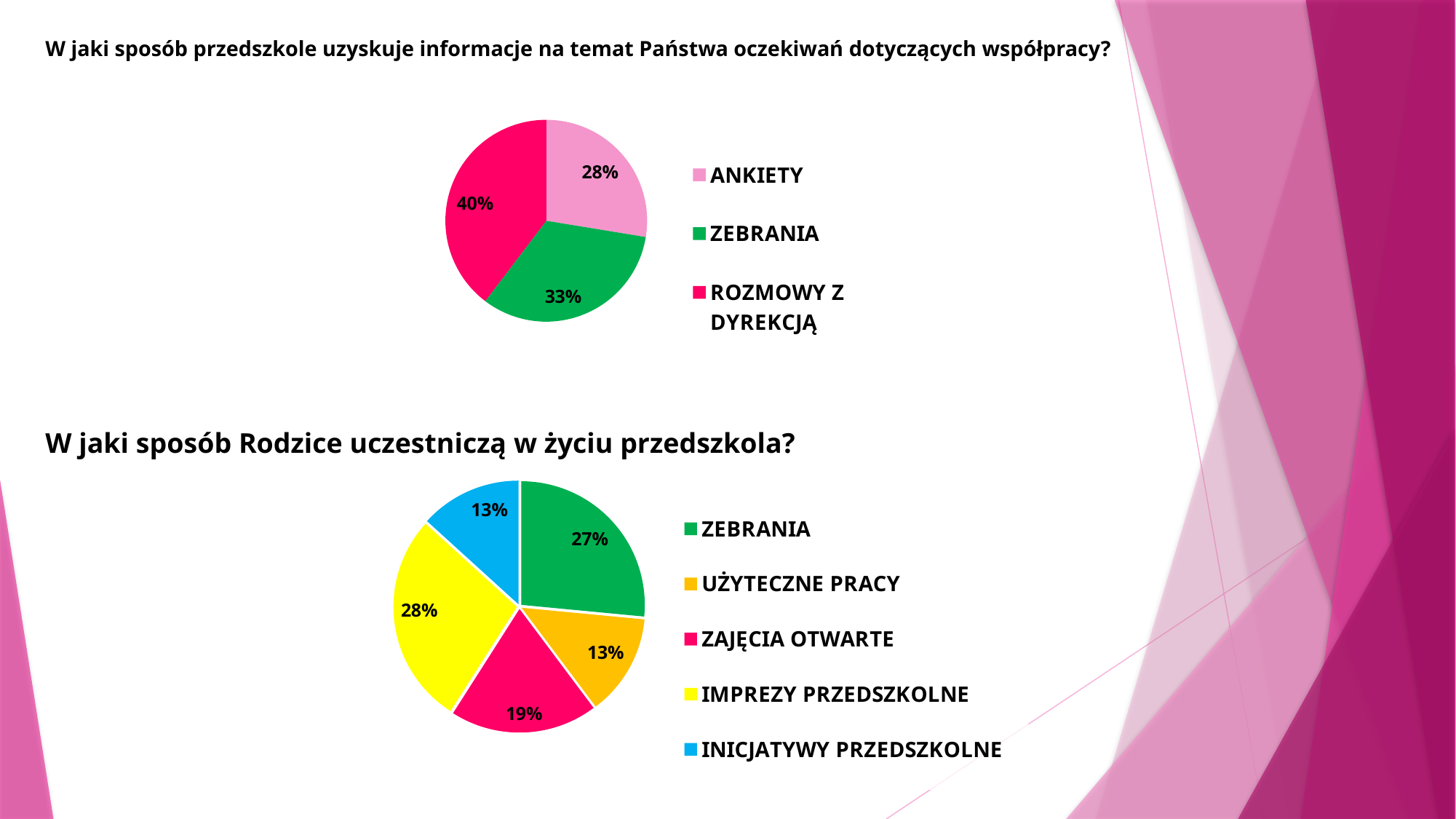
In the bottom pie chart, which is larger: ZEBRANIA or ZAJĘCIA OTWARTE? ZEBRANIA In the bottom pie chart, which category has the largest slice? IMPREZY PRZEDSZKOLNE What type of chart is used for the question 'W jaki sposób Rodzice uczestniczą w życiu przedszkola?'? Pie chart In the top pie chart, which category has the smallest slice? ANKIETY In the bottom pie chart, what share is labelled for IMPREZY PRZEDSZKOLNE? 28% How many categories does the legend of the top pie chart list? 3 How many slices does the bottom pie chart have? 5 In the top pie chart, what share is labelled for ROZMOWY Z DYREKCJĄ? 40% In the top pie chart, what is the difference in percentage points between ROZMOWY Z DYREKCJĄ and ZEBRANIA? 7 In the top pie chart, which category has the largest slice? ROZMOWY Z DYREKCJĄ In the bottom pie chart, what share is labelled for ZAJĘCIA OTWARTE? 19% In the top pie chart, what share is labelled for ANKIETY? 28%